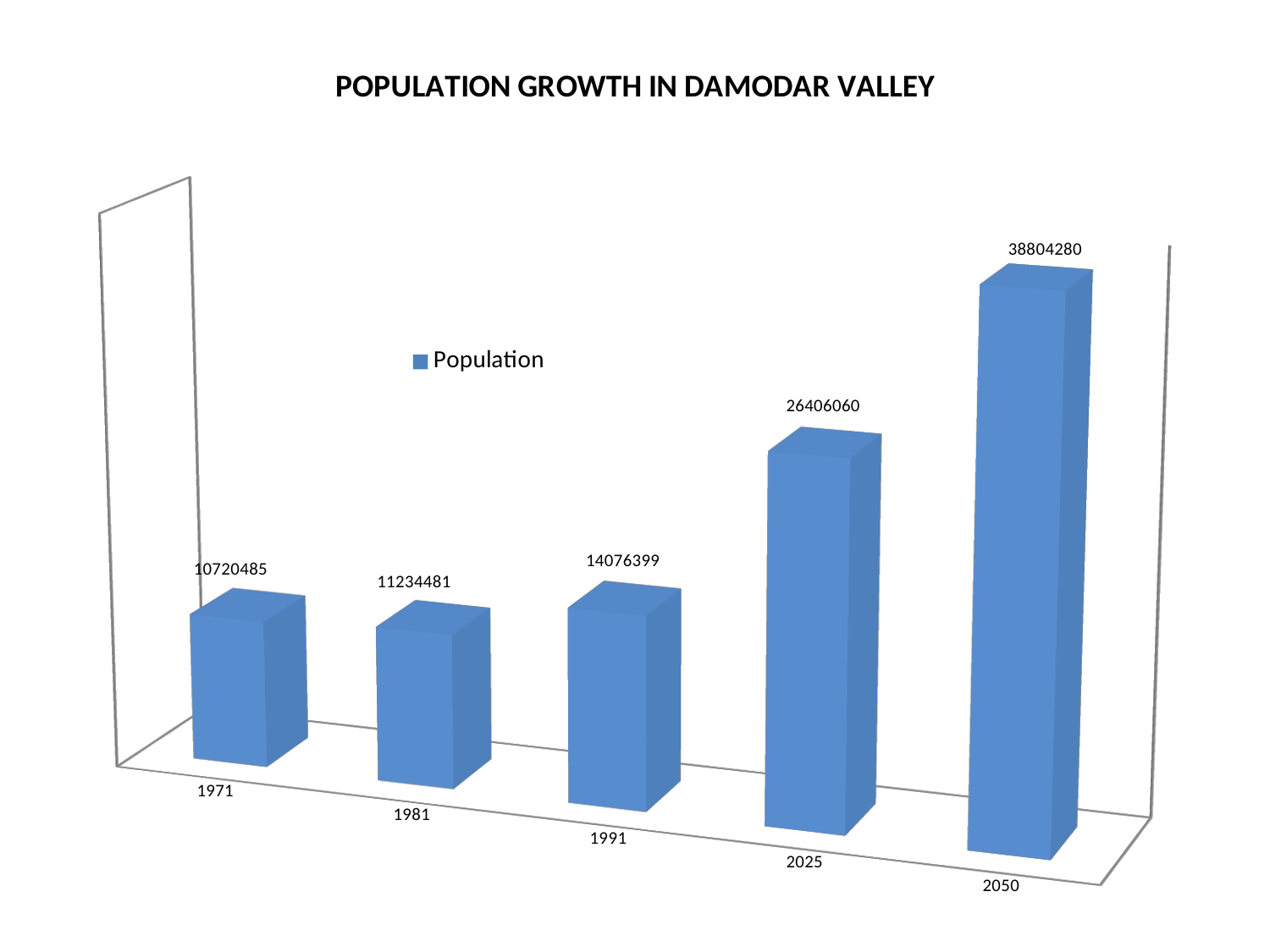
What is the population value shown for 2025? 26406060 Which year has the highest population value? 2050 How many years are shown on the x axis? 5 What is the population value shown for 1991? 14076399 How many series does the legend list? 1 What is the population value shown for 1971? 10720485 What is the difference between the population values for 2050 and 2025? 12398220 What kind of chart is shown on the slide? Bar chart Do the population values rise or fall from 1971 to 2050? Rise Which is larger, the population value for 1991 or for 1981? 1991 What is the difference between the population values for 1981 and 1971? 513996 Which year has the lowest population value? 1971